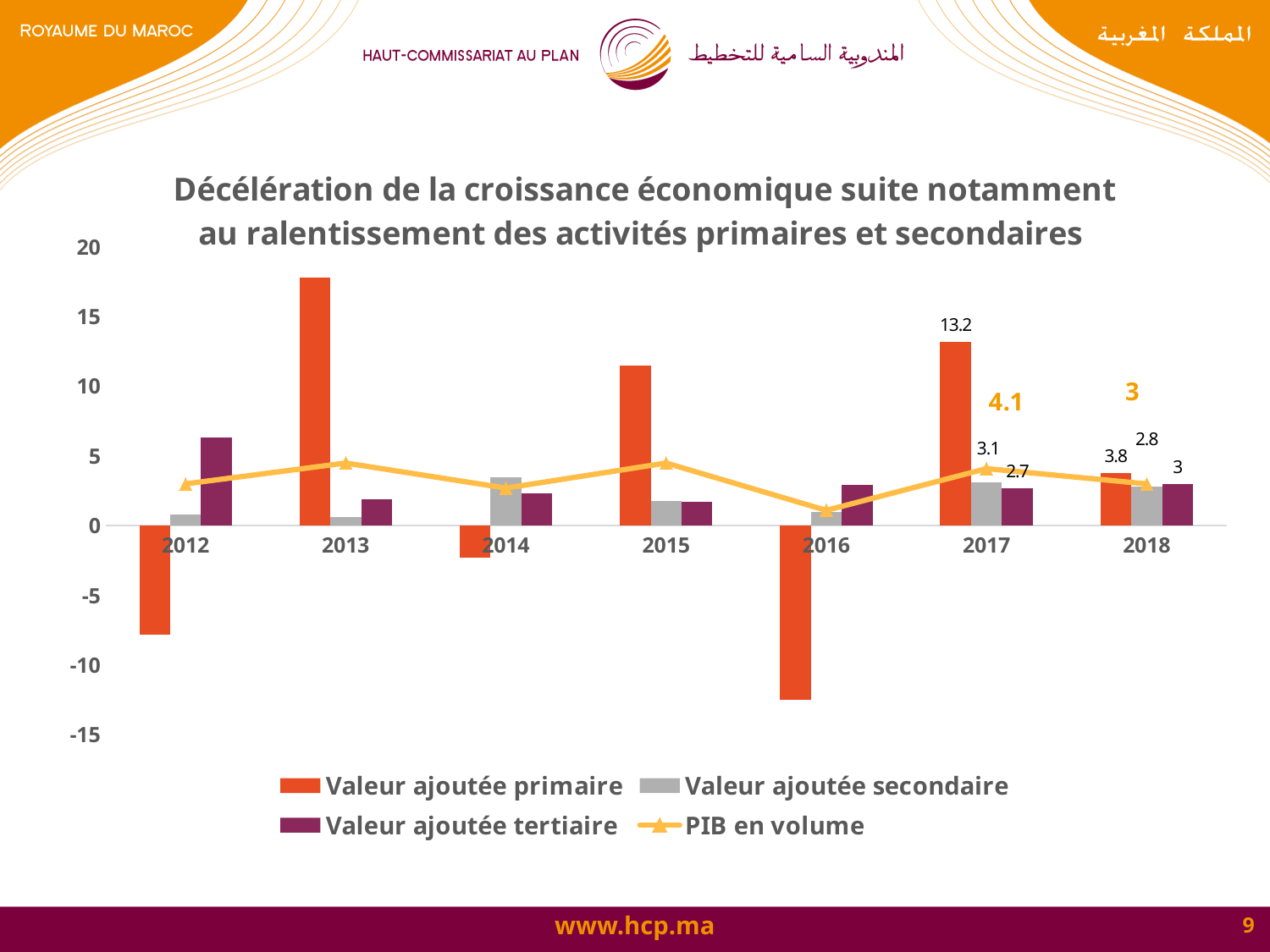
What kind of chart is shown on the slide? Combined bar and line chart What is the value of Valeur ajoutée tertiaire in 2017? 2.7 Which year has the higher PIB en volume, 2017 or 2018? 2017 What is the value of Valeur ajoutée primaire in 2017? 13.2 How many series does the legend list? 4 By how much did Valeur ajoutée primaire fall from 2017 to 2018? 9.4 How many years are shown on the x axis? 7 Is the value for Valeur ajoutée primaire in 2013 greater or less than 15? greater What is the value of PIB en volume in 2018? 3 What is the value of Valeur ajoutée secondaire in 2018? 2.8 In which year is the Valeur ajoutée primaire bar the highest? 2013 In which year is the Valeur ajoutée primaire bar the lowest? 2016